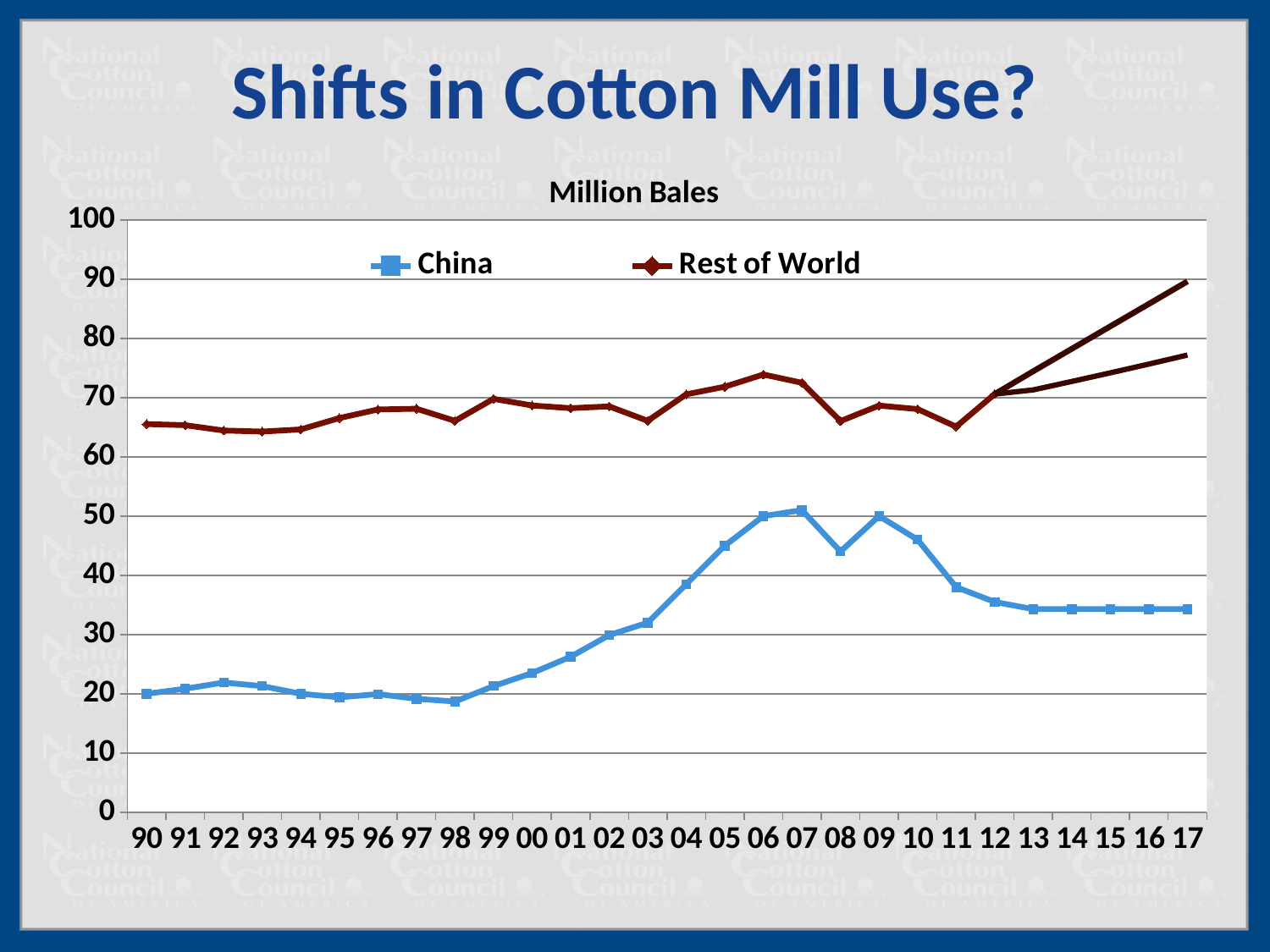
Is the value for China in 01 greater or less than 30? less Does the China line rise or fall from 98 to 06? rise How many years are plotted along the x axis? 28 Is the value for Rest of World in 11 greater or less than 70? less What is the title of the slide? Shifts in Cotton Mill Use? How many series does the legend list? 2 What kind of chart is shown on the slide? line chart Is the value for China in 13 greater or less than 30? greater What unit is shown above the chart? Million Bales In 07, which series has the larger value, China or Rest of World? Rest of World